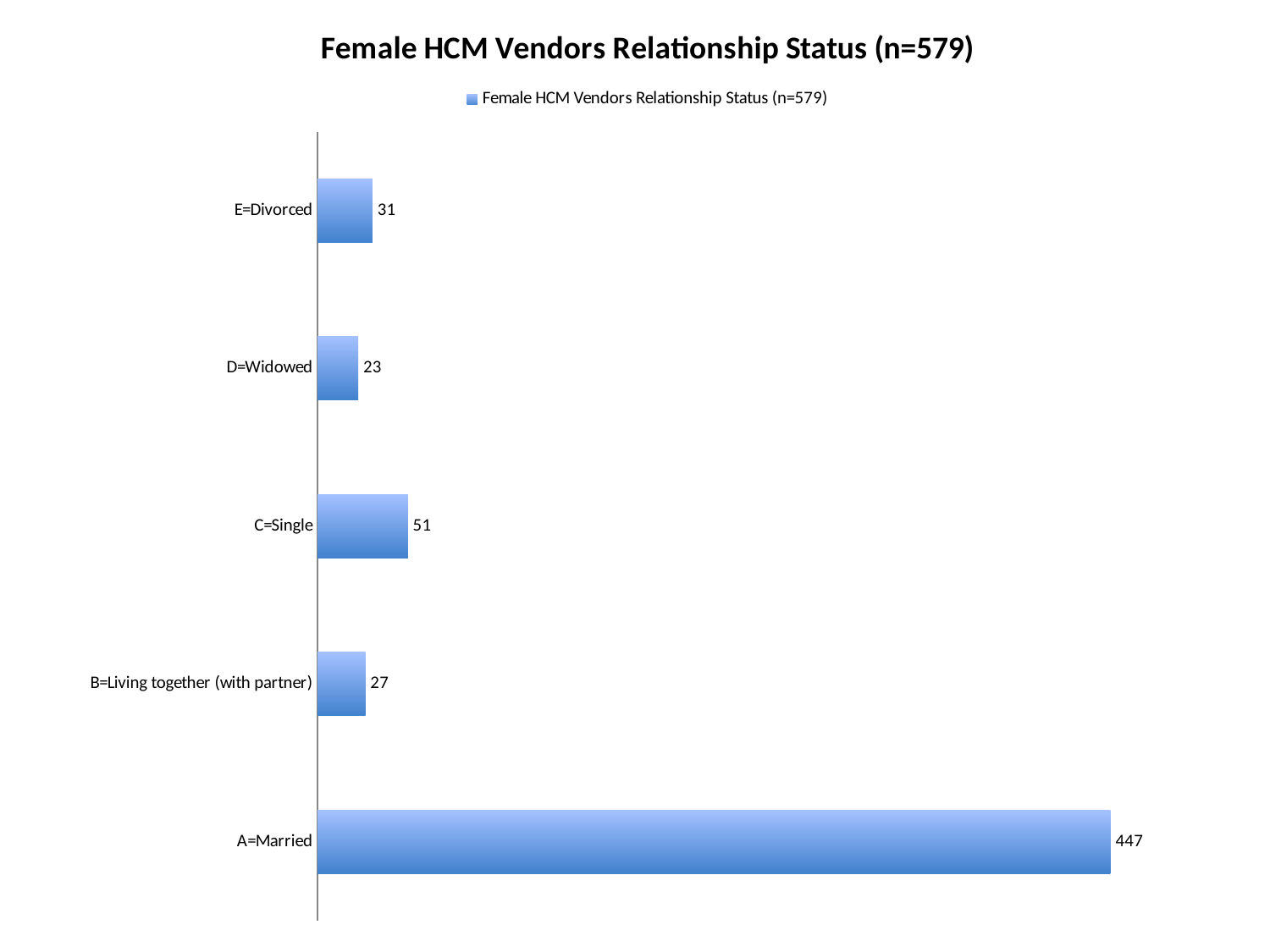
What is the title of the chart? Female HCM Vendors Relationship Status (n=579) What kind of chart is shown on the slide? Bar chart Which category has the lowest value? D=Widowed How many categories are shown in the chart? 5 Which category has the highest value? A=Married What is the value for C=Single? 51 What is the value for A=Married? 447 What is the value for B=Living together (with partner)? 27 What is the value for D=Widowed? 23 Which is larger, the value for E=Divorced or the value for B=Living together (with partner)? E=Divorced What is the difference between the values for A=Married and C=Single? 396 What is the difference between the values for E=Divorced and D=Widowed? 8